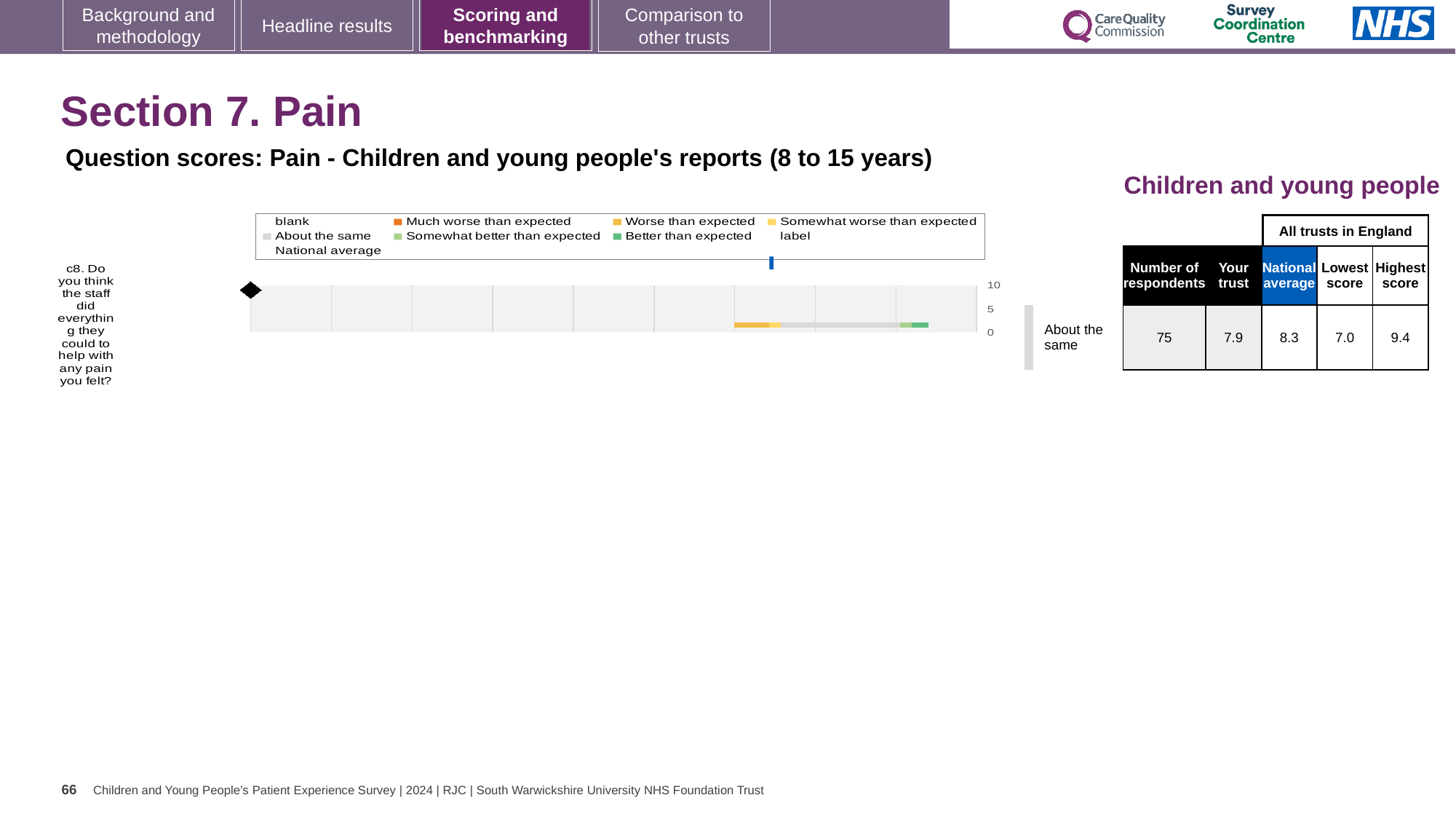
What is the highest score among all trusts in England for question c8? 9.4 By how much does the national average exceed the 'Your trust' score for question c8? 0.4 What is the difference between the highest score and the lowest score for question c8? 2.4 For question c8, which is larger: the 'Your trust' score or the national average? National average What is the national average score for question c8? 8.3 How many survey questions are plotted in the chart? 1 What benchmark category is the trust's result for question c8 placed in? About the same What is the maximum value shown on the chart's score axis? 10 What is the 'Your trust' score for question c8? 7.9 What is the lowest score among all trusts in England for question c8? 7.0 What kind of chart is used to show the question score for c8? bar chart What is the number of respondents for question c8 shown in the table next to the chart? 75